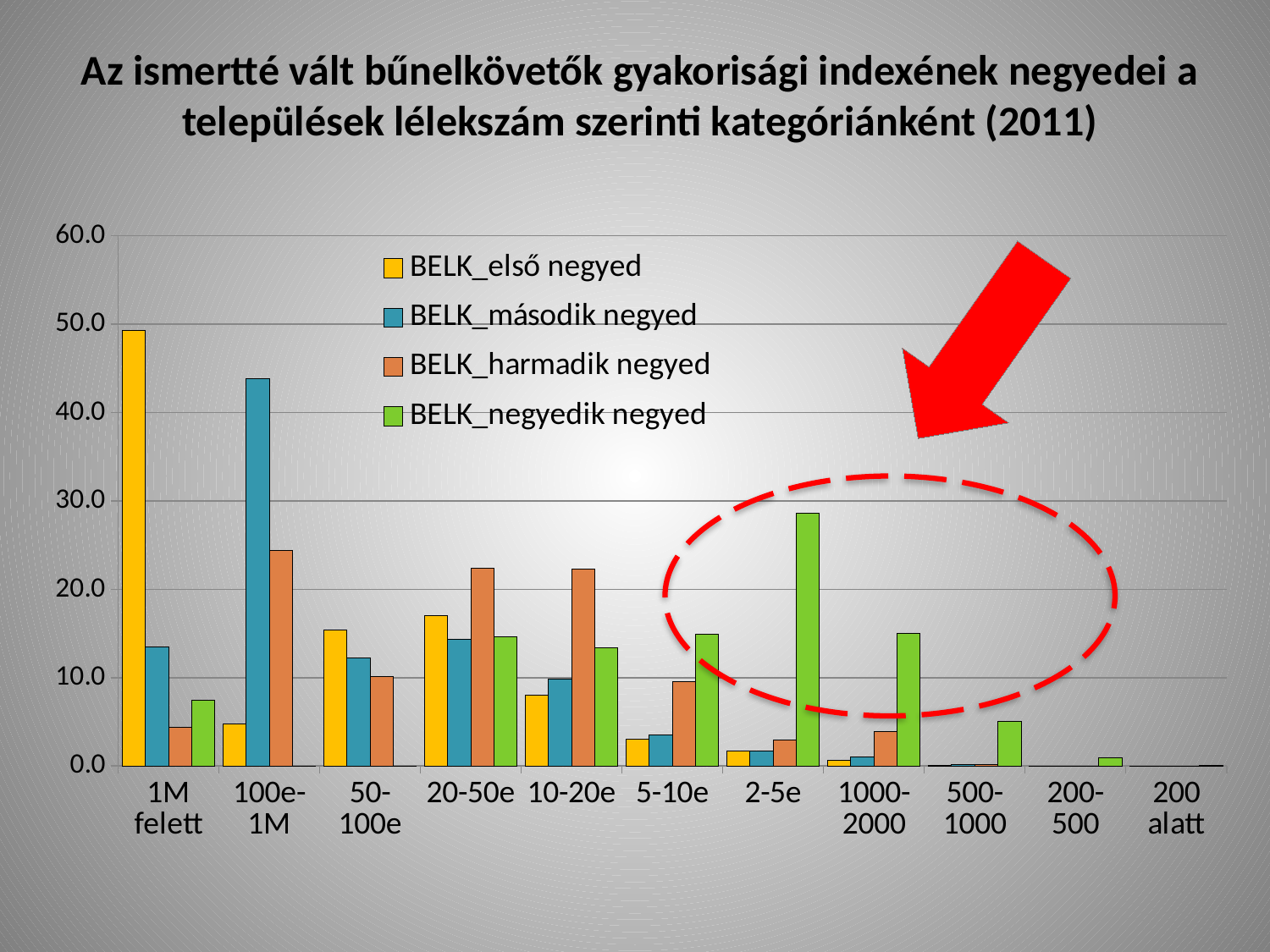
Which series is shown in green in the legend? BELK_negyedik negyed In the 100e-1M category, which is larger: BELK_második negyed or BELK_harmadik negyed? BELK_második negyed For the BELK_negyedik negyed series, which category has the highest value? 2-5e For the BELK_első negyed series, which category has the highest value? 1M felett For the BELK_második negyed series, which category has the highest value? 100e-1M Is the value for BELK_második negyed in the 100e-1M category greater or less than 40.0? greater How many series does the legend list? 4 What kind of chart is shown on the slide? bar chart How many settlement size categories are shown on the x axis? 11 In the 2-5e category, which is larger: BELK_negyedik negyed or BELK_első negyed? BELK_negyedik negyed Is the value for BELK_negyedik negyed in the 2-5e category greater or less than 20.0? greater Is the value for BELK_első negyed in the 1M felett category greater or less than 40.0? greater